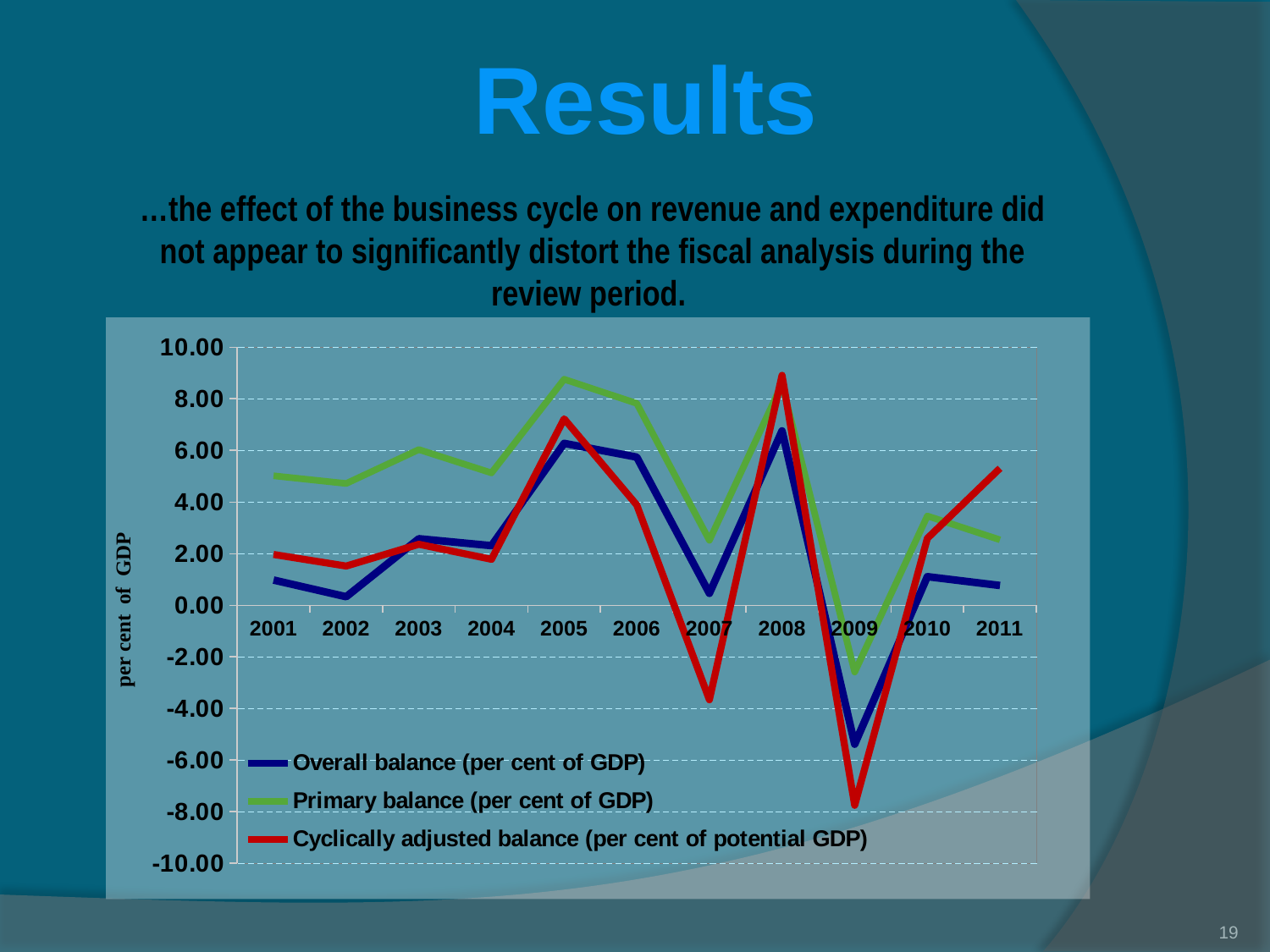
What kind of chart is shown on the slide? Line chart How many years are plotted along the x axis? 11 In which year is the Cyclically adjusted balance (per cent of potential GDP) at its highest? 2008 How many series does the legend list? 3 Does the Overall balance (per cent of GDP) rise or fall from 2008 to 2009? Fall Is the Primary balance (per cent of GDP) in 2005 greater or less than 8.00? greater In 2001, which is larger: the Primary balance or the Overall balance? Primary balance In 2008, which is larger: the Cyclically adjusted balance or the Overall balance? Cyclically adjusted balance What is the label on the vertical axis of the chart? per cent of GDP In which year is the Overall balance (per cent of GDP) at its lowest? 2009 In which year is the Cyclically adjusted balance (per cent of potential GDP) at its lowest? 2009 Is the Cyclically adjusted balance (per cent of potential GDP) in 2009 greater or less than -6.00? less